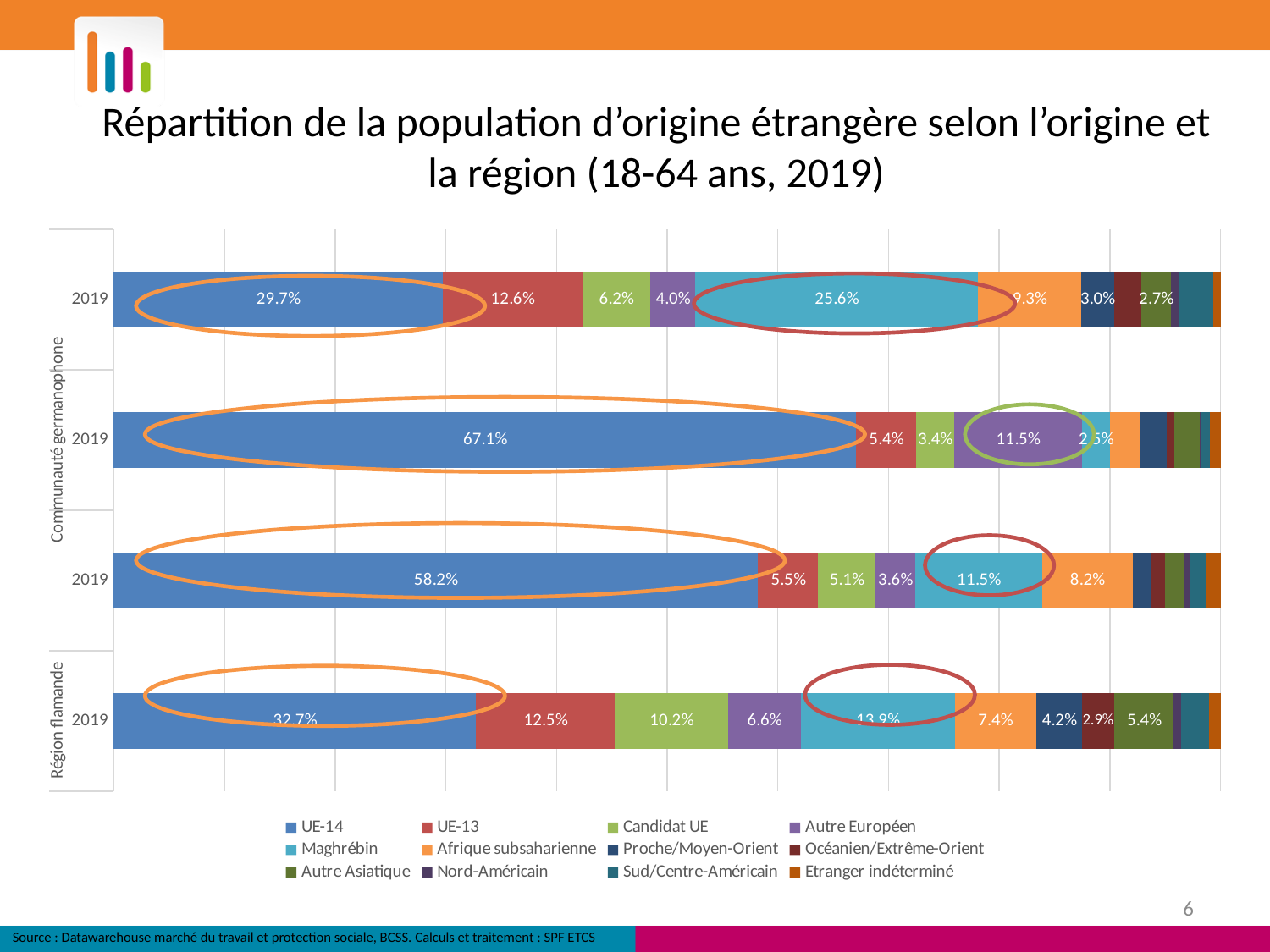
In the top bar, what is the difference between the UE-14 value and the Maghrébin value? 4.1 percentage points Which bar has the highest UE-14 share? The second bar from the top (67.1%) In the top bar, what is the value for UE-14? 29.7% How many series does the legend list? 12 In the second bar from the top, what is the value for UE-14? 67.1% How many bars are plotted in the chart? 4 In the third bar from the top, what is the value for Afrique subsaharienne? 8.2% In the bottom bar (Région flamande), what is the value for Candidat UE? 10.2% What kind of chart is shown on the slide? Stacked bar chart In the top bar, what is the value for Maghrébin? 25.6% In the bottom bar (Région flamande), what is the value for UE-13? 12.5% Which bar has the larger UE-14 share: the second bar from the top or the third bar from the top? The second bar from the top